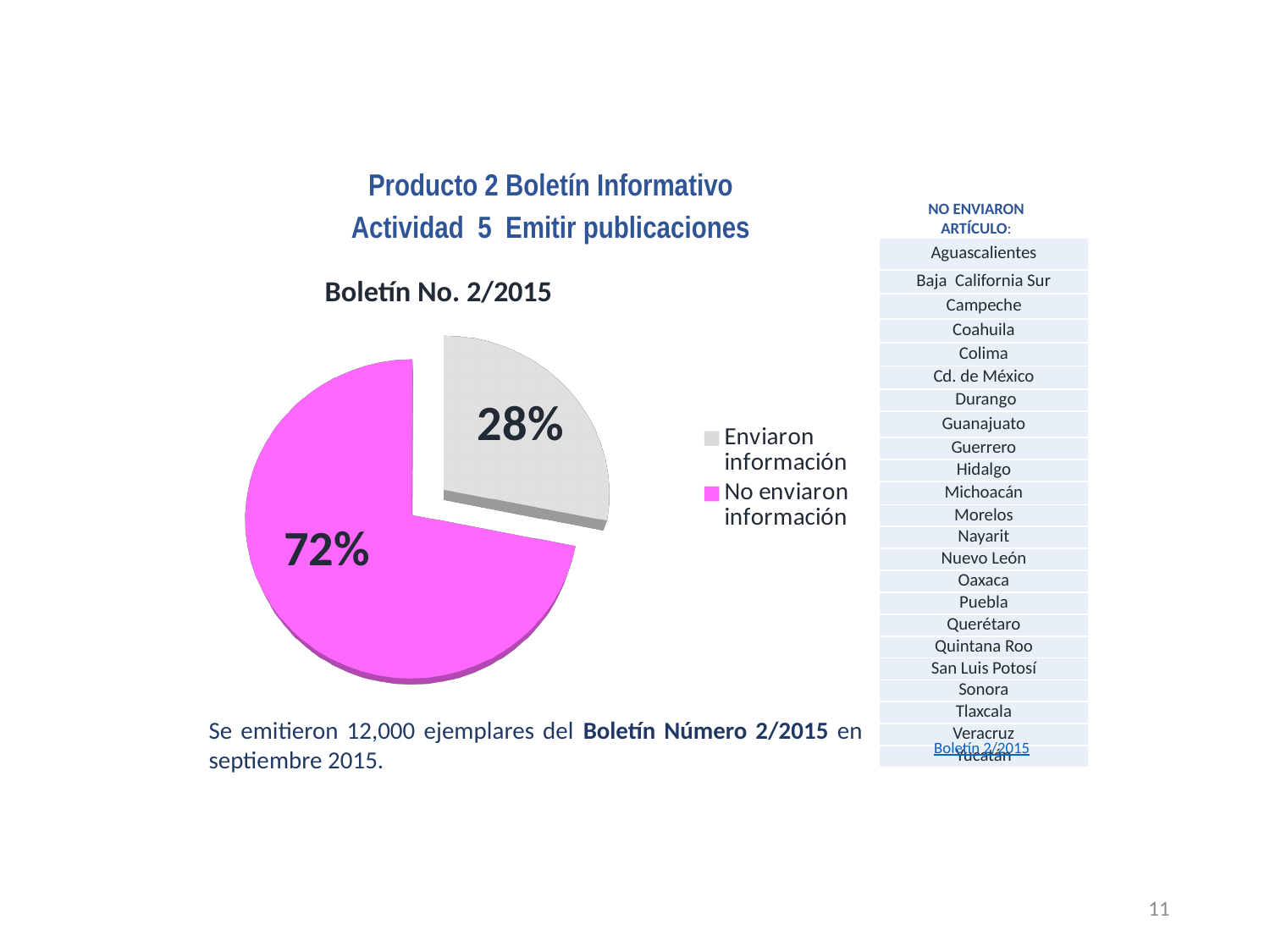
What is the difference in percentage points between "No enviaron información" and "Enviaron información"? 44 What percentage of the pie is labelled "No enviaron información"? 72% What type of chart is shown on the slide? Pie chart Is the share for "Enviaron información" greater or less than 50%? less How many entries does the legend list? 2 What is the title of the chart? Boletín No. 2/2015 Which is larger: the share for "Enviaron información" or the share for "No enviaron información"? No enviaron información Which category has the smallest share of the pie? Enviaron información How many slices does the pie chart have? 2 What percentage of the pie is labelled "Enviaron información"? 28% What colour is the slice for "No enviaron información"? Pink Which category has the largest share of the pie? No enviaron información